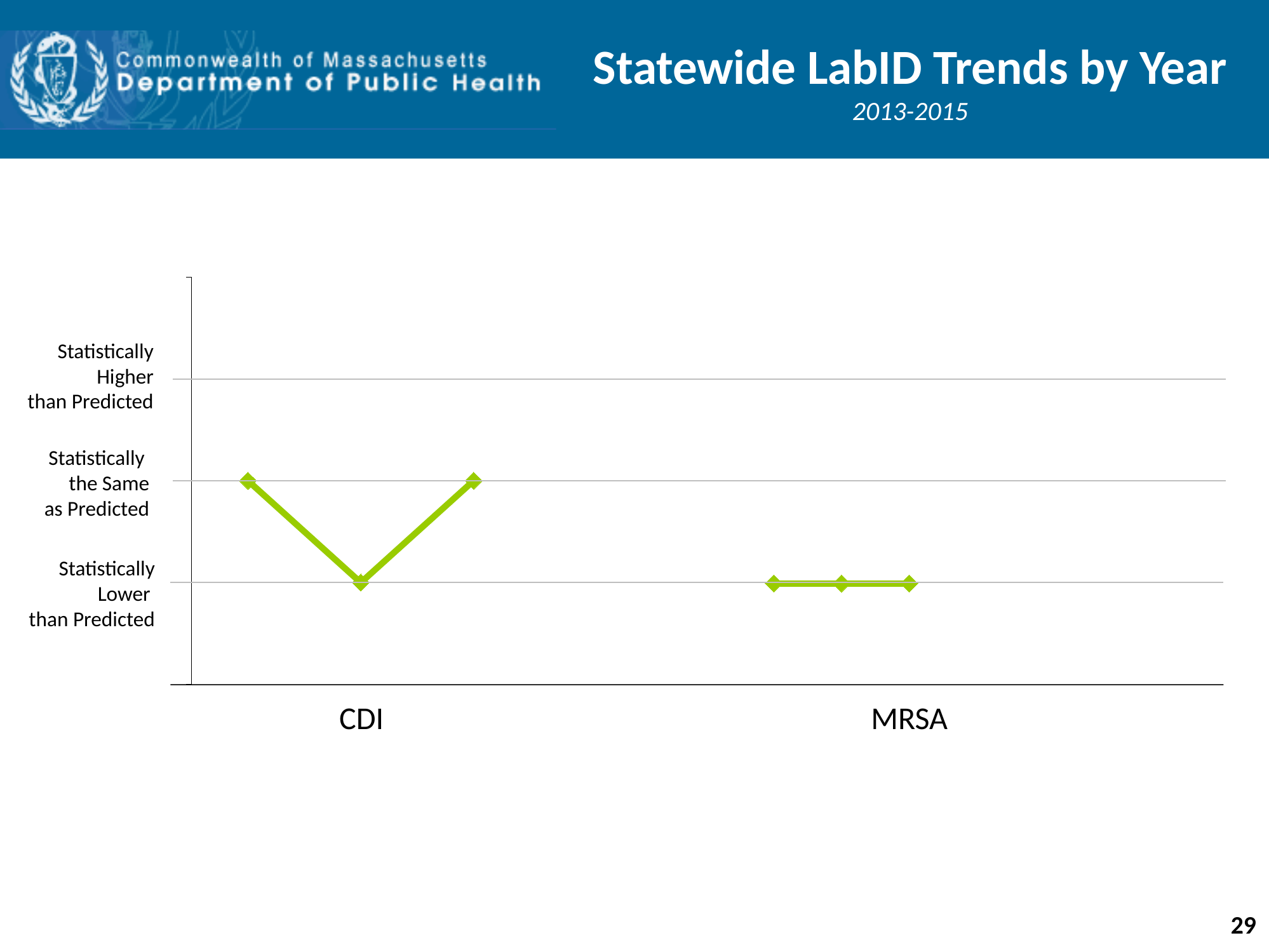
Which y-axis level does the first (leftmost) CDI point fall on? Statistically the Same as Predicted How many categories are labelled on the x axis of the chart? 2 What year range is given in the subtitle of the slide? 2013-2015 What kind of chart is shown on the slide? line chart Do the CDI points rise or fall between the first and middle point? fall Do the MRSA points rise, fall, or stay flat from left to right? stay flat How many data points are plotted for CDI? 3 Which y-axis level does the last (rightmost) CDI point fall on? Statistically the Same as Predicted Which y-axis level does the middle CDI point fall on? Statistically Lower than Predicted What is the title of the chart slide? Statewide LabID Trends by Year How many data points are plotted for MRSA? 3 Which y-axis level do all three MRSA points fall on? Statistically Lower than Predicted